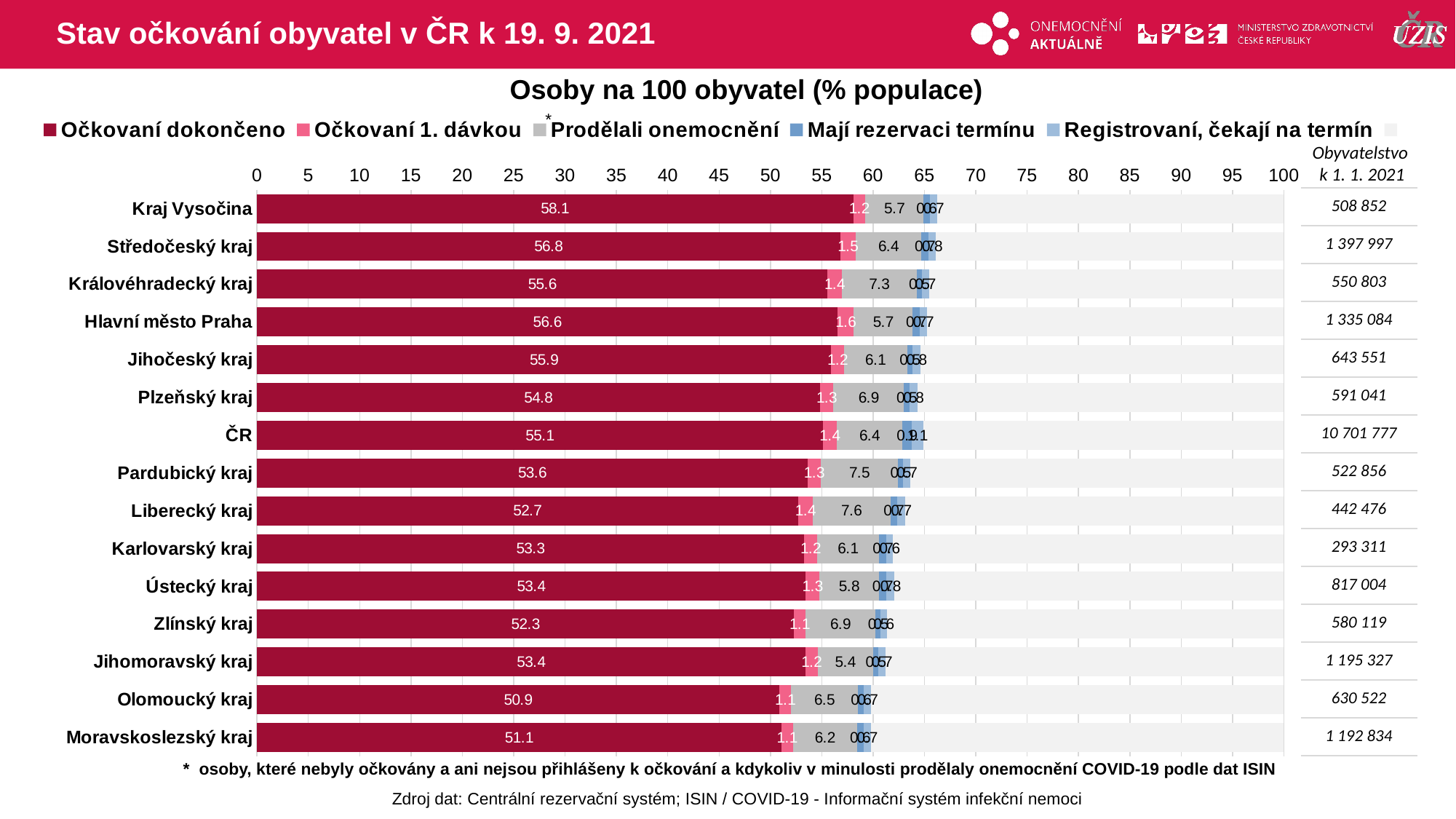
What is the value of Prodělali onemocnění for ČR? 6.4 What kind of chart is shown on the slide? bar chart Which has a higher value of Očkovaní dokončeno, Středočeský kraj or Hlavní město Praha? Středočeský kraj How many categories (rows) are plotted in the chart? 15 What is the value of Prodělali onemocnění for Liberecký kraj? 7.6 Which region has the highest value of Očkovaní dokončeno? Kraj Vysočina What is the difference in Očkovaní dokončeno between Kraj Vysočina and Olomoucký kraj? 7.2 Which region has the lowest value of Očkovaní dokončeno? Olomoucký kraj Is the value of Očkovaní dokončeno for Moravskoslezský kraj greater or less than 55? less What is the value of Očkovaní 1. dávkou for Hlavní město Praha? 1.6 What is the value of Očkovaní dokončeno for Kraj Vysočina? 58.1 What is the title of the chart? Osoby na 100 obyvatel (% populace)